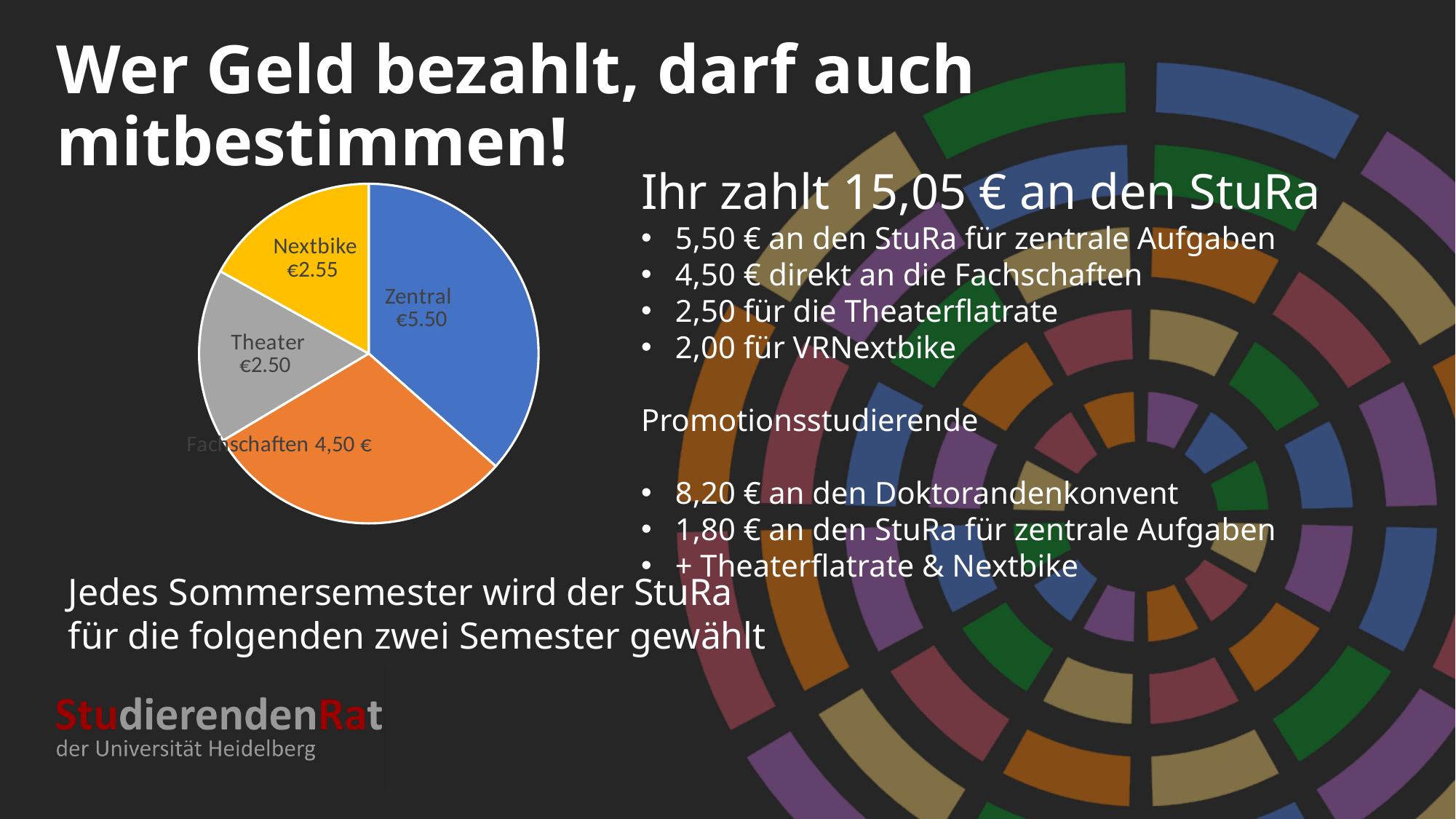
What is the difference between the Zentral and Fachschaften values in the pie chart? €1.00 What is the value shown for the Fachschaften slice of the pie chart? 4,50 € Which is larger in the pie chart, Zentral or Fachschaften? Zentral What colour is the Zentral slice of the pie chart? blue What is the value shown for the Zentral slice of the pie chart? €5.50 What is the value shown for the Nextbike slice of the pie chart? €2.55 What is the value shown for the Theater slice of the pie chart? €2.50 Which slice of the pie chart has the largest value? Zentral What kind of chart is shown on the slide? pie chart Which slice of the pie chart has the smallest value? Theater How many slices does the pie chart have? 4 What is the difference between the Zentral and Theater values in the pie chart? €3.00